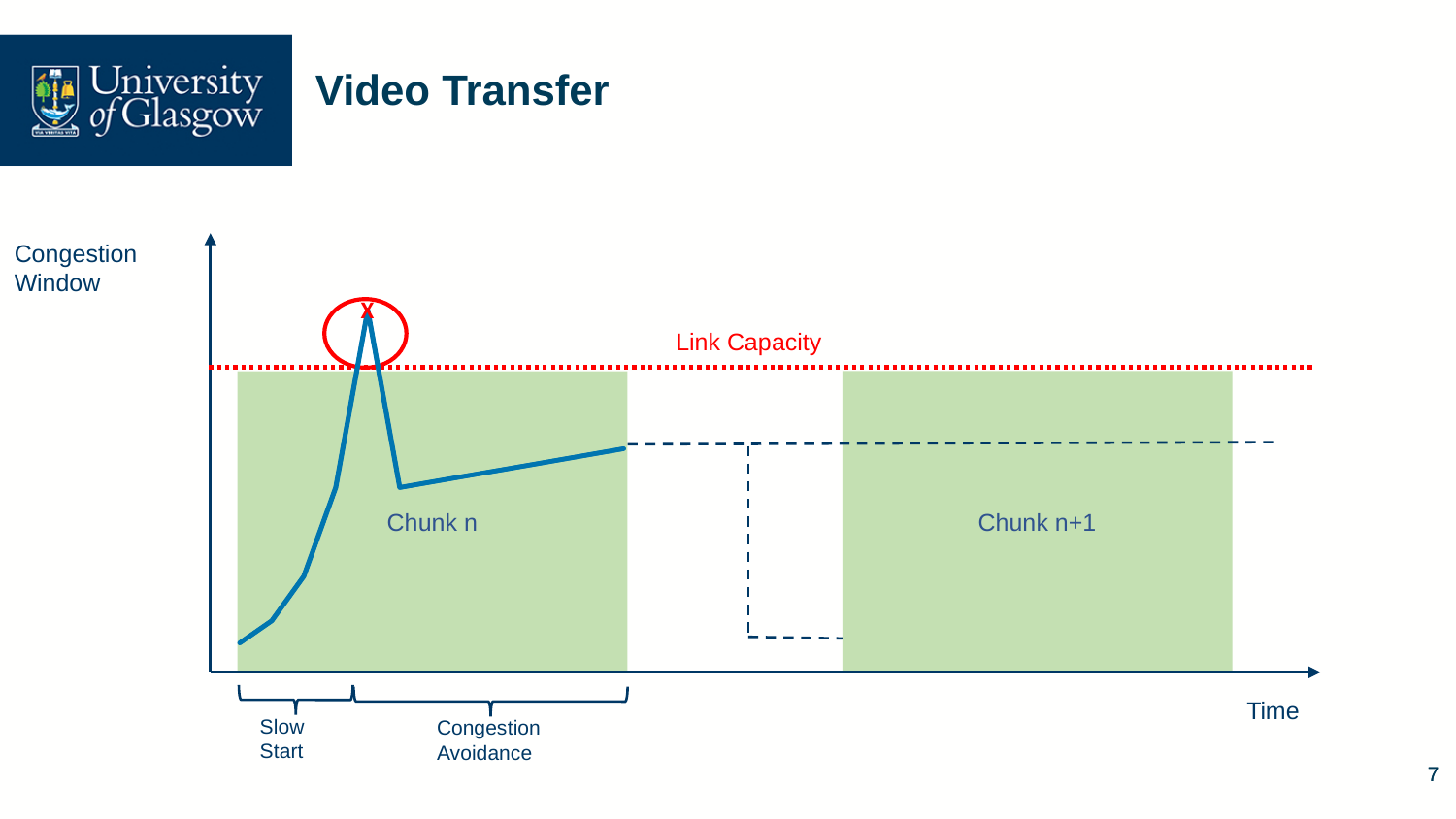
Which phase comes first along the time axis, Slow Start or Congestion Avoidance? Slow Start Is the congestion window at the end of Chunk n above or below the Link Capacity line? below What is the label on the horizontal axis of the chart? Time Does the congestion window rise or fall along the Congestion Avoidance phase after the drop? rise Is the peak of the congestion window line above or below the Link Capacity line? above Which chunk appears later on the time axis, Chunk n or Chunk n+1? Chunk n+1 How many green shaded chunk regions are shown on the chart? 2 What kind of chart is shown on the slide? line chart What is the label on the vertical axis of the chart? Congestion Window Does the congestion window rise or fall during the Slow Start phase? rise